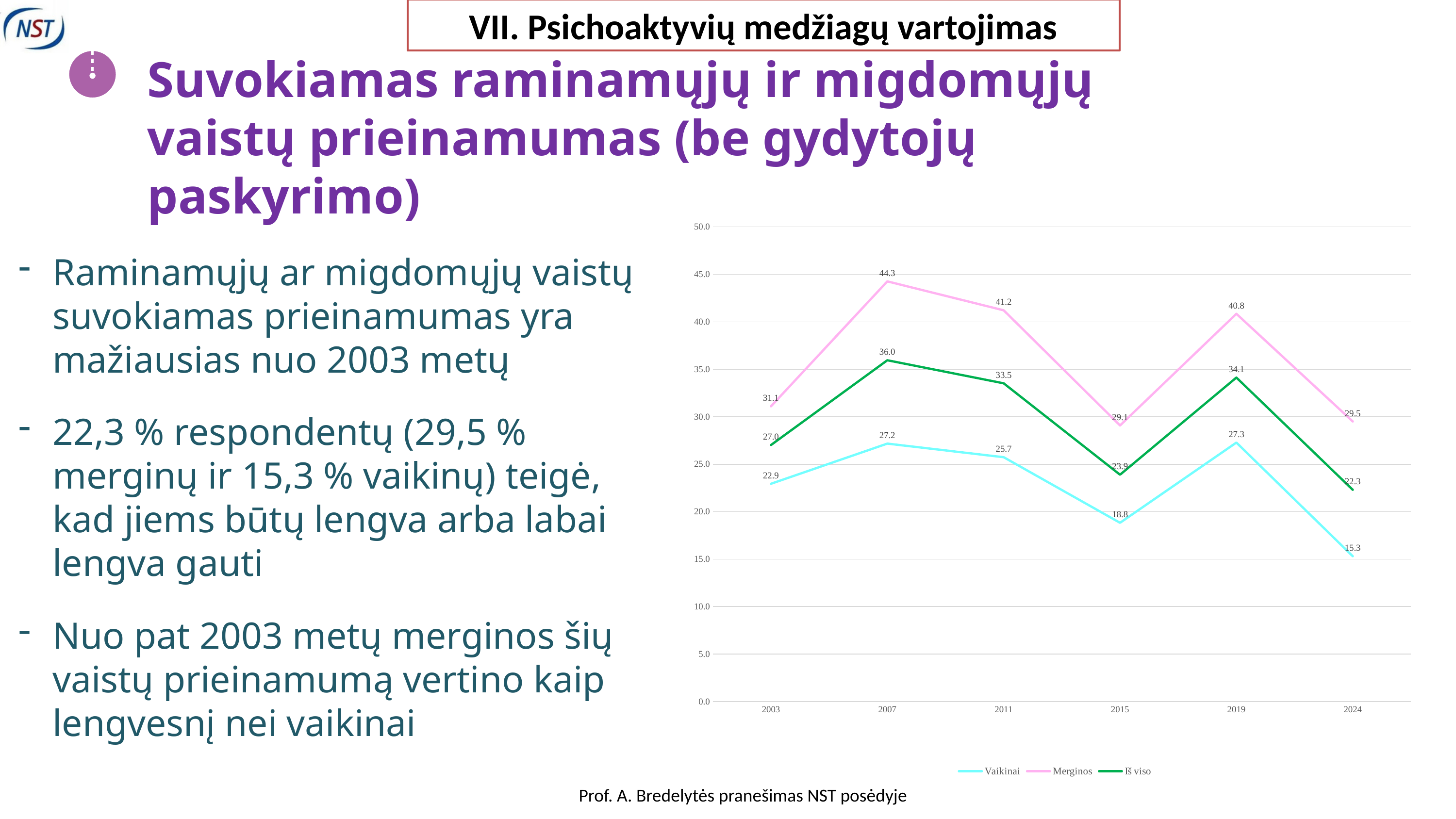
How many years are plotted along the x axis of the chart? 6 In which year is the Merginos series at its highest? 2007 Which series is drawn in pink on the chart? Merginos In which year is the Vaikinai series at its lowest? 2024 What is the difference between the Merginos and Vaikinai values in 2024? 14.2 What is the value for Vaikinai in 2024? 15.3 Does the Iš viso series rise or fall from 2019 to 2024? fall What is the value for Merginos in 2007? 44.3 How many series does the chart legend list? 3 What type of chart is shown on the slide? line chart What is the value for Iš viso in 2015? 23.9 Which is larger in 2019: the value for Merginos or the value for Vaikinai? Merginos